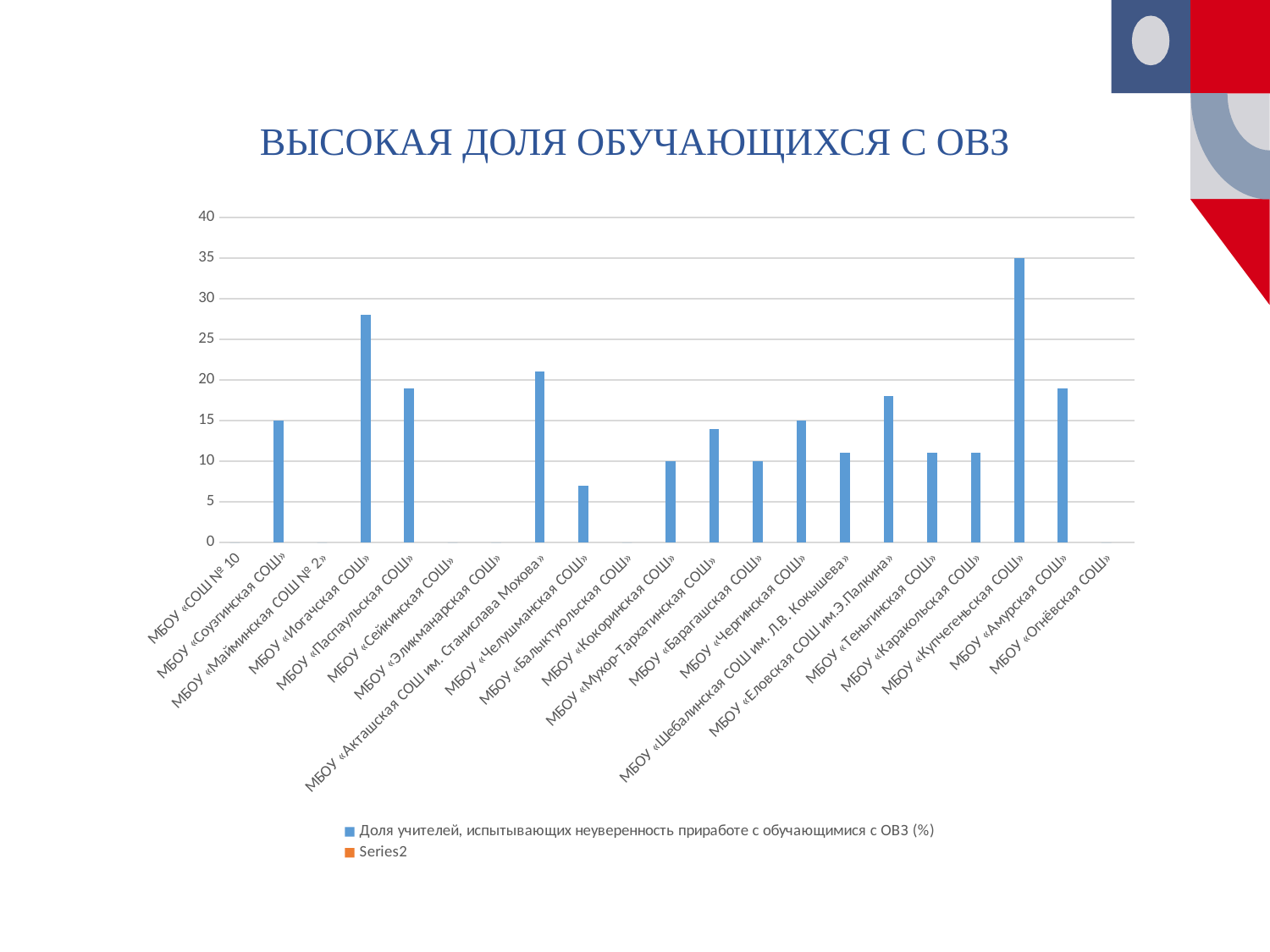
Is the value for МБОУ «Балыктуюльская СОШ» greater or less than 10? less How many series does the legend list? 2 Is the value for МБОУ «Еловская СОШ» greater or less than 15? greater Which is larger, the value for МБОУ «Иогачская СОШ» or МБОУ «Паспаульская СОШ»? МБОУ «Иогачская СОШ» Which school has the highest value? МБОУ «Купчегеньская СОШ» What is the value for МБОУ «Купчегеньская СОШ»? 35 What is the value for МБОУ «Соузгинская СОШ»? 15 What is the title of the slide? ВЫСОКАЯ ДОЛЯ ОБУЧАЮЩИХСЯ С ОВЗ What is the value for МБОУ «Кокоринская СОШ»? 10 How many school categories are shown on the x axis? 21 What type of chart is shown on the slide? bar chart Is the value for МБОУ «Иогачская СОШ» greater or less than 25? greater